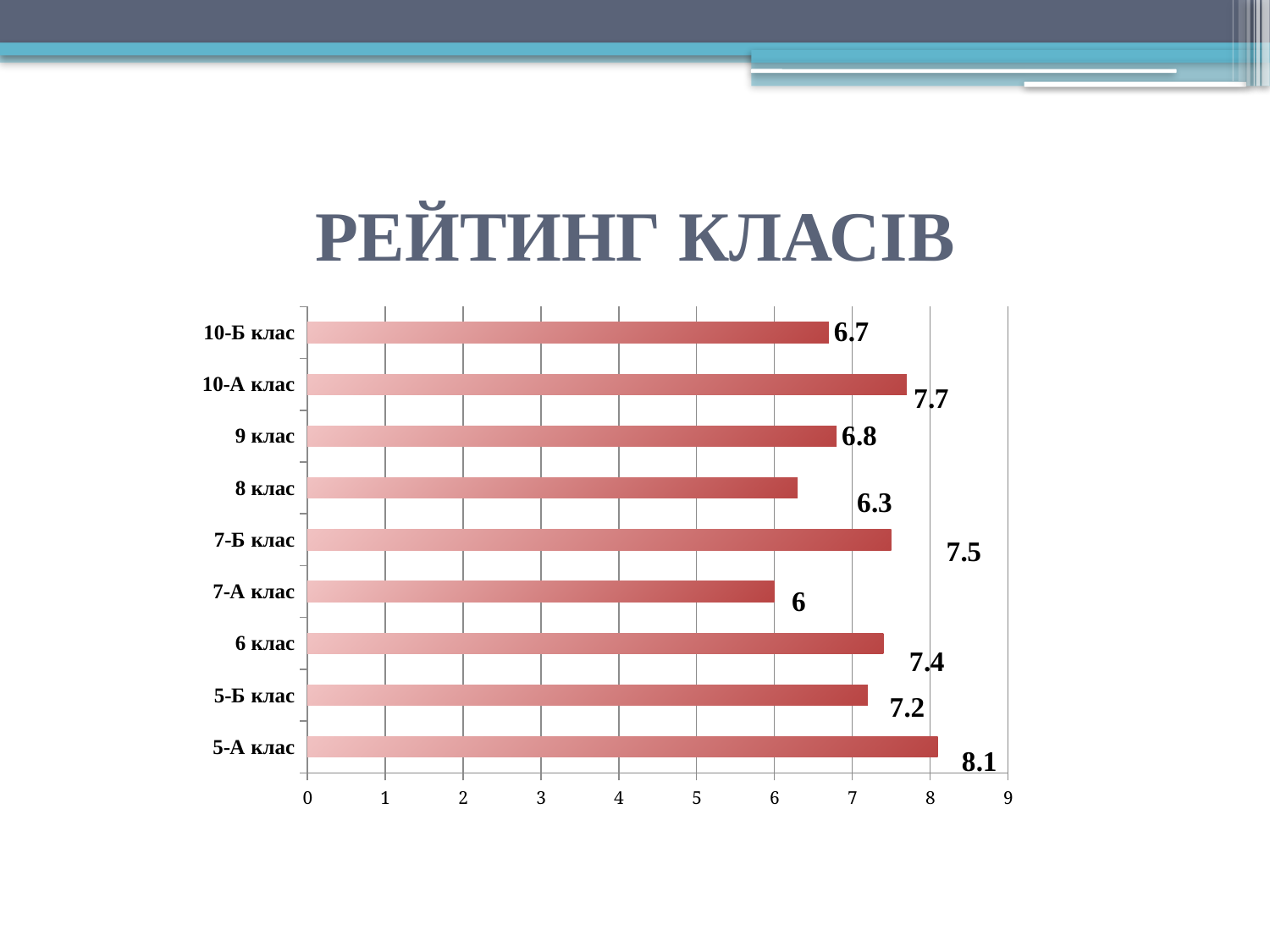
What is the value for 7-А клас? 6 Which class has the lowest value? 7-А клас What is the difference between the values for 10-А клас and 10-Б клас? 1 What is the title of the chart? РЕЙТИНГ КЛАСІВ How many classes are shown in the chart? 9 What is the difference between the values for 5-А клас and 7-А клас? 2.1 Is the value for 7-Б клас greater or less than 7? greater What kind of chart is shown on the slide? bar chart Which is larger, the value for 9 клас or the value for 8 клас? 9 клас What is the value for 5-А клас? 8.1 What is the value for 10-А клас? 7.7 Which class has the highest value? 5-А клас